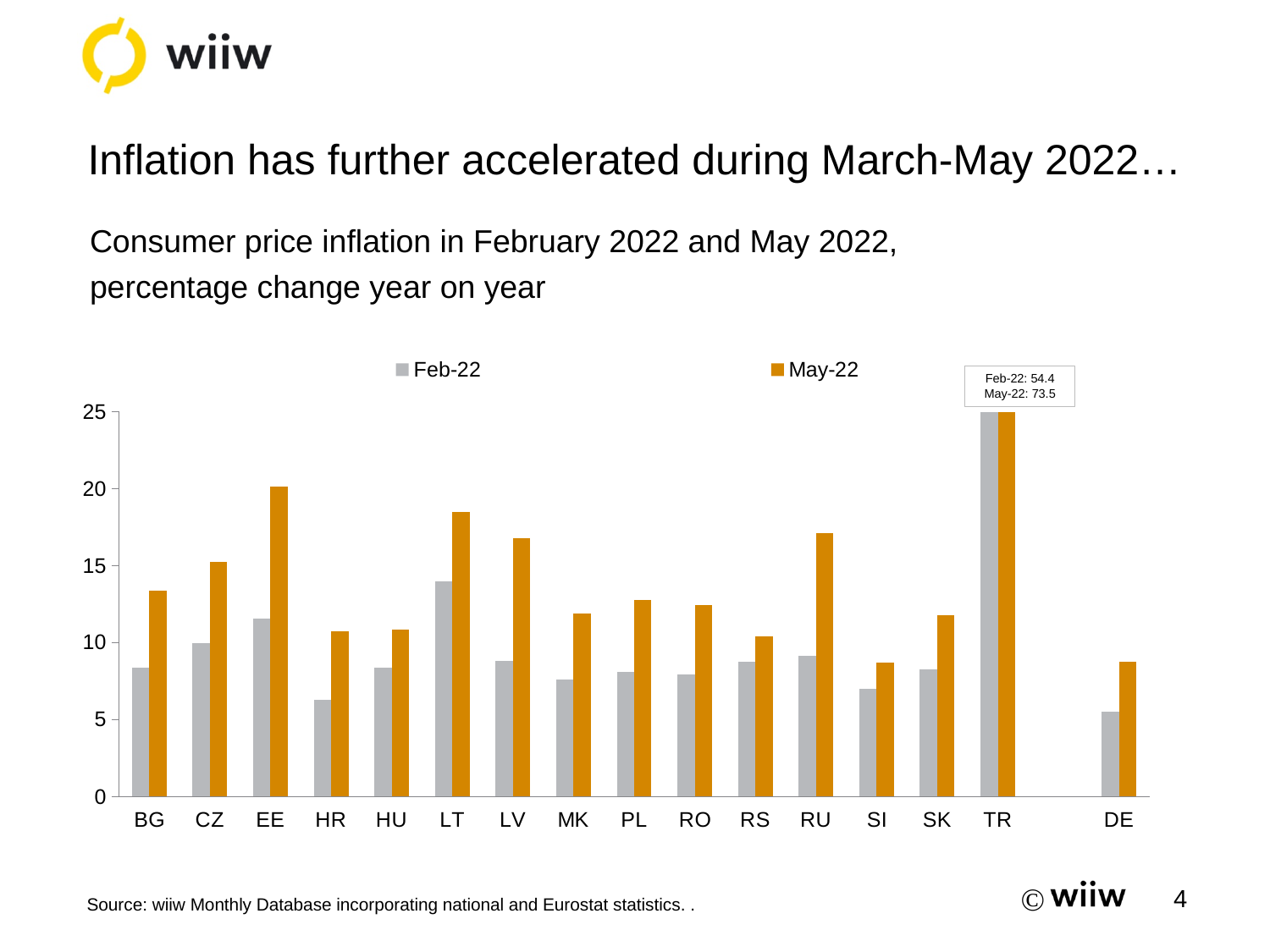
Which country has the highest May-22 value? TR What is the Feb-22 inflation value for TR? 54.4 By how much did TR's inflation rise from Feb-22 to May-22? 19.1 Which colour represents the May-22 series in the chart? orange Which country has the lowest Feb-22 value? DE What is the May-22 inflation value for TR? 73.5 Which has the larger May-22 value, EE or LT? EE How many series does the legend list? 2 Is the May-22 value for LT greater or less than 15? greater How many countries are shown on the x axis of the chart? 16 Is the Feb-22 value for HR greater or less than 10? less What kind of chart is shown on the slide? bar chart